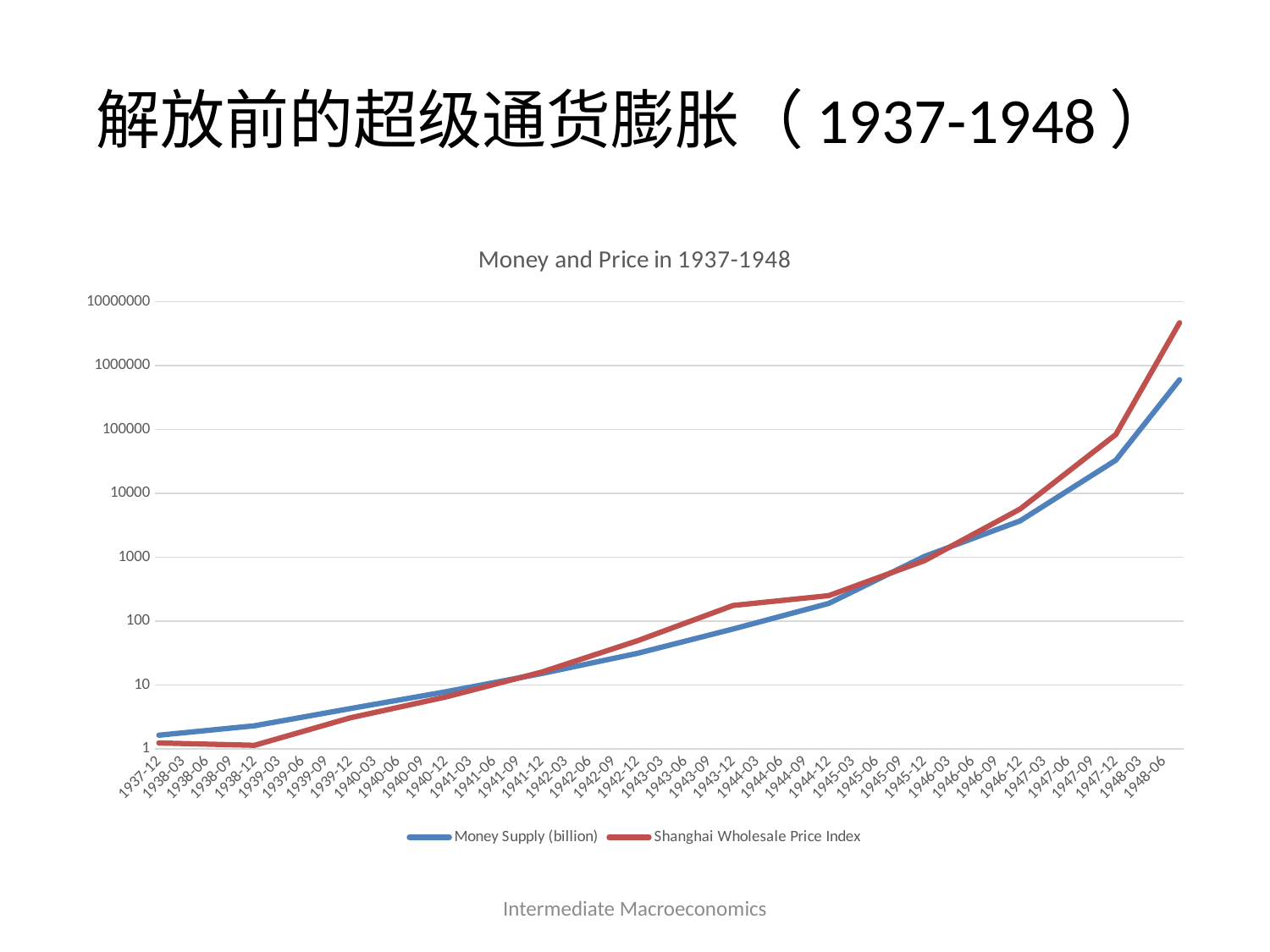
Is the value of Money Supply (billion) at 1947-12 greater or less than 10000? greater Do the values of the Shanghai Wholesale Price Index rise or fall from 1937-12 to 1948-06? rise Is the value of the Shanghai Wholesale Price Index at 1948-06 greater or less than 1000000? greater Is the value of Money Supply (billion) at 1948-06 greater or less than 1000000? less At 1938-12, which series has the higher value, Money Supply (billion) or Shanghai Wholesale Price Index? Money Supply (billion) At 1948-06, which series has the higher value, Money Supply (billion) or Shanghai Wholesale Price Index? Shanghai Wholesale Price Index Which series is drawn in red? Shanghai Wholesale Price Index What kind of chart is shown on the slide? line chart How many series does the legend list? 2 How many time points are labelled on the x axis? 43 What is the title of the chart? Money and Price in 1937-1948